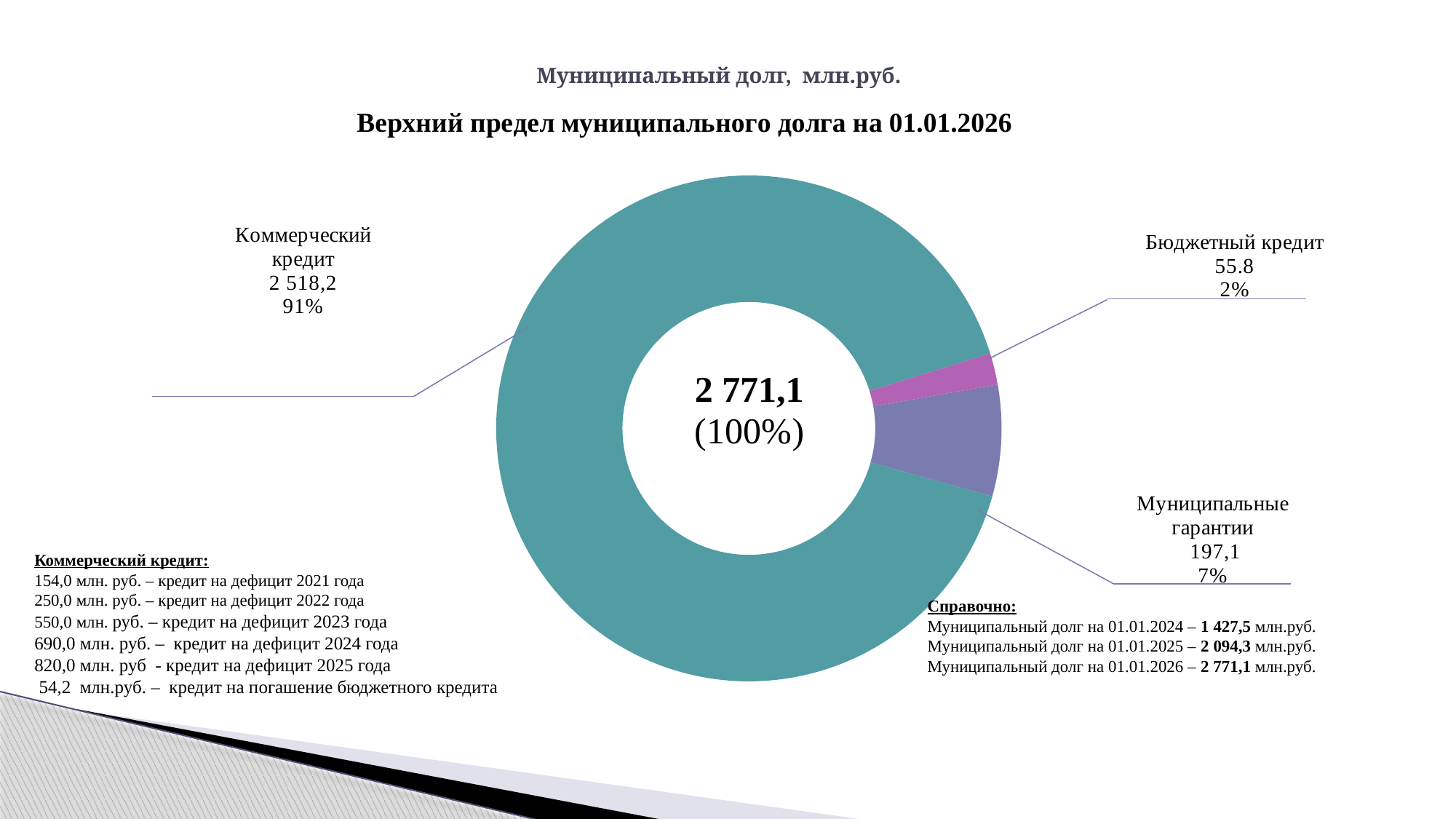
How many categories does the chart show? 3 What is the value for Бюджетный кредит? 55.8 What share of the total does Муниципальные гарантии represent? 7% What is the value for Коммерческий кредит? 2 518,2 What total value is shown in the centre of the chart? 2 771,1 What is the value for Муниципальные гарантии? 197,1 Which category has the smallest value? Бюджетный кредит Which category has the largest value? Коммерческий кредит What share of the total does Коммерческий кредит represent? 91% Which is larger, Муниципальные гарантии or Бюджетный кредит? Муниципальные гарантии What share of the total does Бюджетный кредит represent? 2% What kind of chart is shown on the slide? Donut (pie) chart